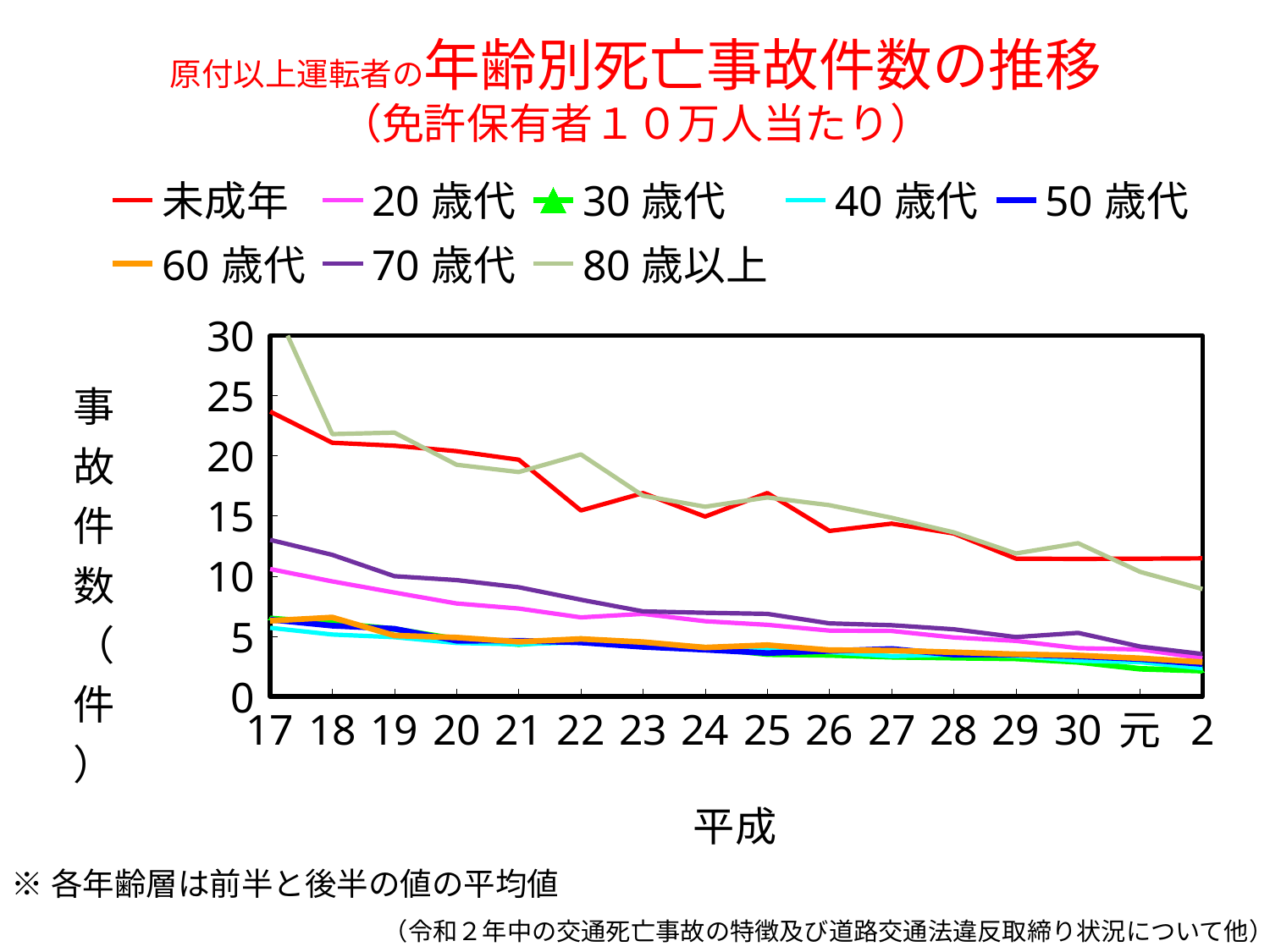
Which series has the highest value at 2 (the last point) on the x axis? 未成年 Does the 未成年 series generally rise or fall from 17 to 2 along the x axis? fall What is the label of the x axis? 平成 Is the value for 30歳代 at 2 (the last point) greater or less than 5? less At 22 on the x axis, which is larger: 80歳以上 or 未成年? 80歳以上 Is the value for 未成年 at 17 greater or less than 20? greater Is the value for 80歳以上 at 17 greater or less than 25? greater Which series has the highest value at 17 on the x axis? 80歳以上 How many points are on the x axis of the chart? 16 What kind of chart is shown on the slide? line chart How many series does the legend list? 8